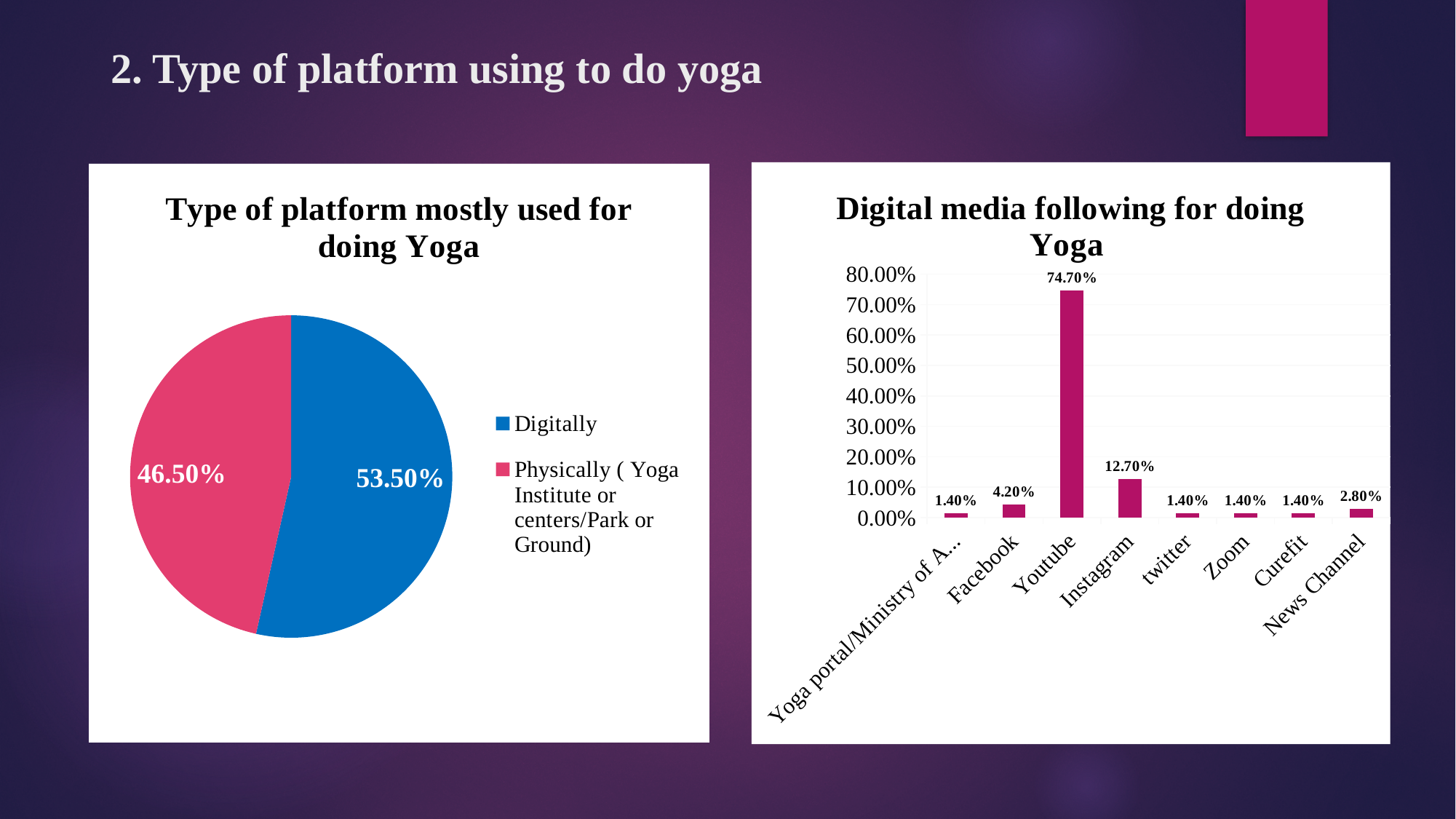
In the 'Digital media following for doing Yoga' chart, what is the value for Youtube? 74.70% How many categories are shown in the 'Digital media following for doing Yoga' chart? 8 What kind of chart is 'Digital media following for doing Yoga'? Bar chart In the 'Digital media following for doing Yoga' chart, what is the value for Instagram? 12.70% In the 'Type of platform mostly used for doing Yoga' chart, which slice is larger, Digitally or Physically? Digitally In the 'Digital media following for doing Yoga' chart, which category has the highest value? Youtube In the 'Type of platform mostly used for doing Yoga' chart, what is the difference between the Digitally and Physically shares? 7.00% In the 'Type of platform mostly used for doing Yoga' chart, what share is labelled for Digitally? 53.50% In the 'Digital media following for doing Yoga' chart, what is the value for News Channel? 2.80% In the 'Digital media following for doing Yoga' chart, what is the difference between the Youtube and Instagram values? 62.00% In the 'Type of platform mostly used for doing Yoga' chart, what share is labelled for Physically (Yoga Institute or centers/Park or Ground)? 46.50% What kind of chart is 'Type of platform mostly used for doing Yoga'? Pie chart